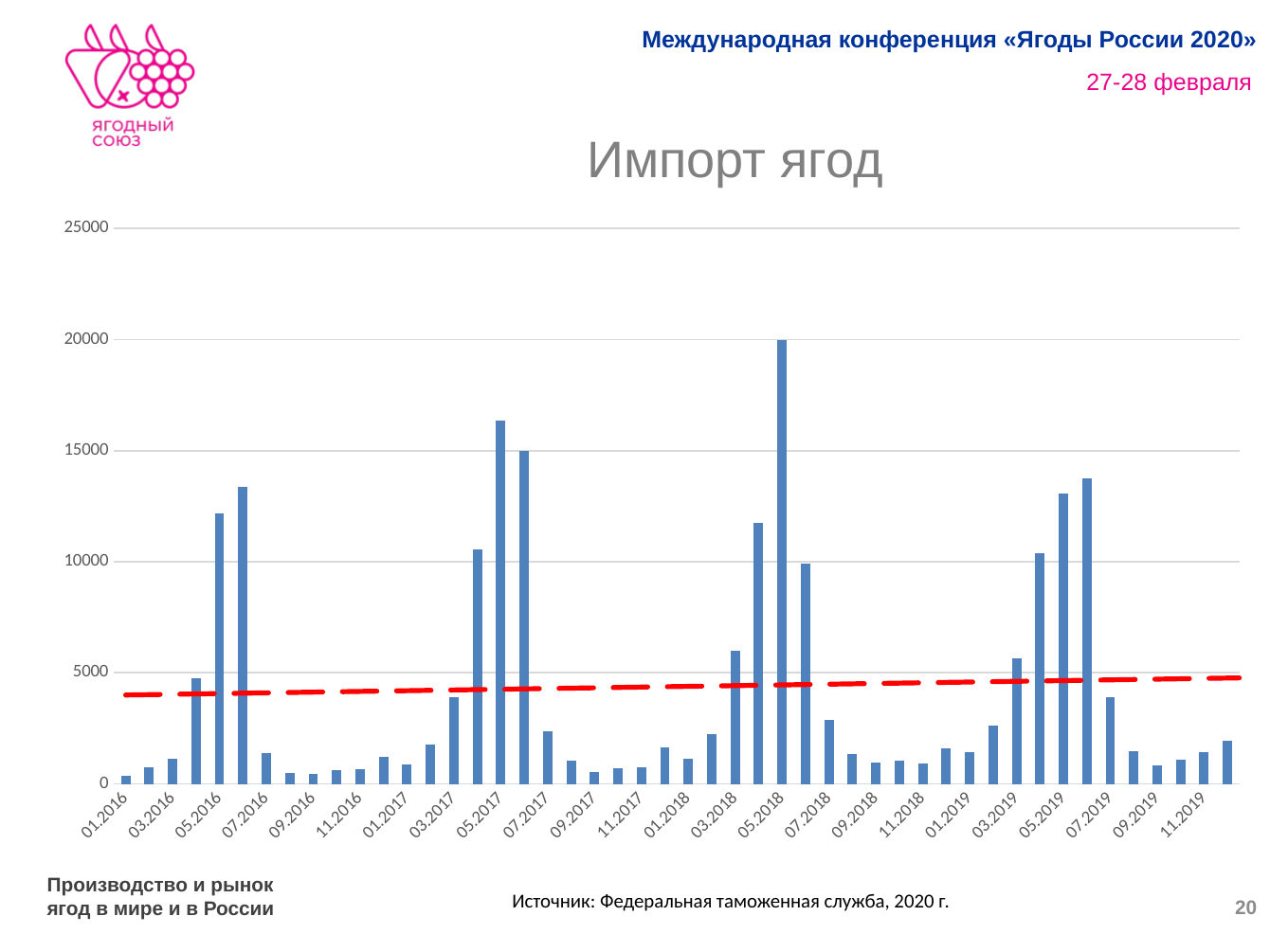
Which month has the highest bar in the chart? 05.2018 Is the value for 01.2016 greater or less than 5000? less Is the value for 05.2017 greater or less than 15000? greater Is the value for 07.2019 greater or less than 5000? less Which is larger, the value for 05.2018 or the value for 05.2016? 05.2018 What is the title of the chart? Импорт ягод How many month labels are shown on the x axis? 24 What type of chart is shown on the slide? bar chart Which is larger, the value for 05.2017 or the value for 05.2019? 05.2017 Does the red dashed line rise or fall from left to right? rises